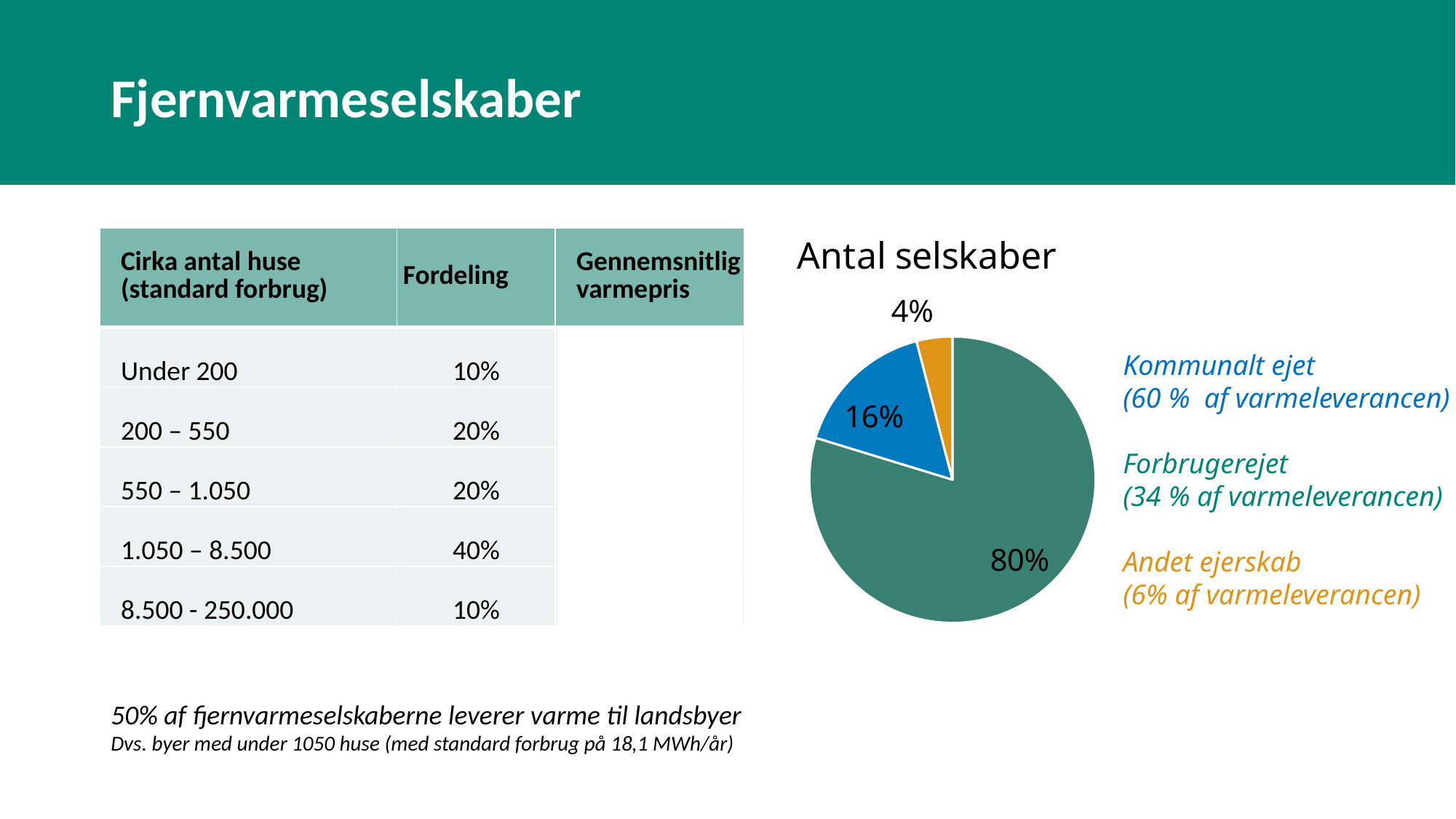
Which category has the largest slice in the pie chart? Forbrugerejet What kind of chart is shown under the title "Antal selskaber"? pie chart What colour is the Kommunalt ejet slice in the pie chart? blue What share of the pie chart does the Forbrugerejet slice represent? 80% What share of the pie chart does the Andet ejerskab slice represent? 4% What is the title of the pie chart? Antal selskaber Which slice is larger in the pie chart, Kommunalt ejet or Andet ejerskab? Kommunalt ejet What share of the pie chart does the Kommunalt ejet slice represent? 16% How many slices does the pie chart have? 3 What is the combined share of the Kommunalt ejet and Andet ejerskab slices? 20% Which category has the smallest slice in the pie chart? Andet ejerskab What is the difference in percentage points between the Forbrugerejet slice and the Kommunalt ejet slice? 64